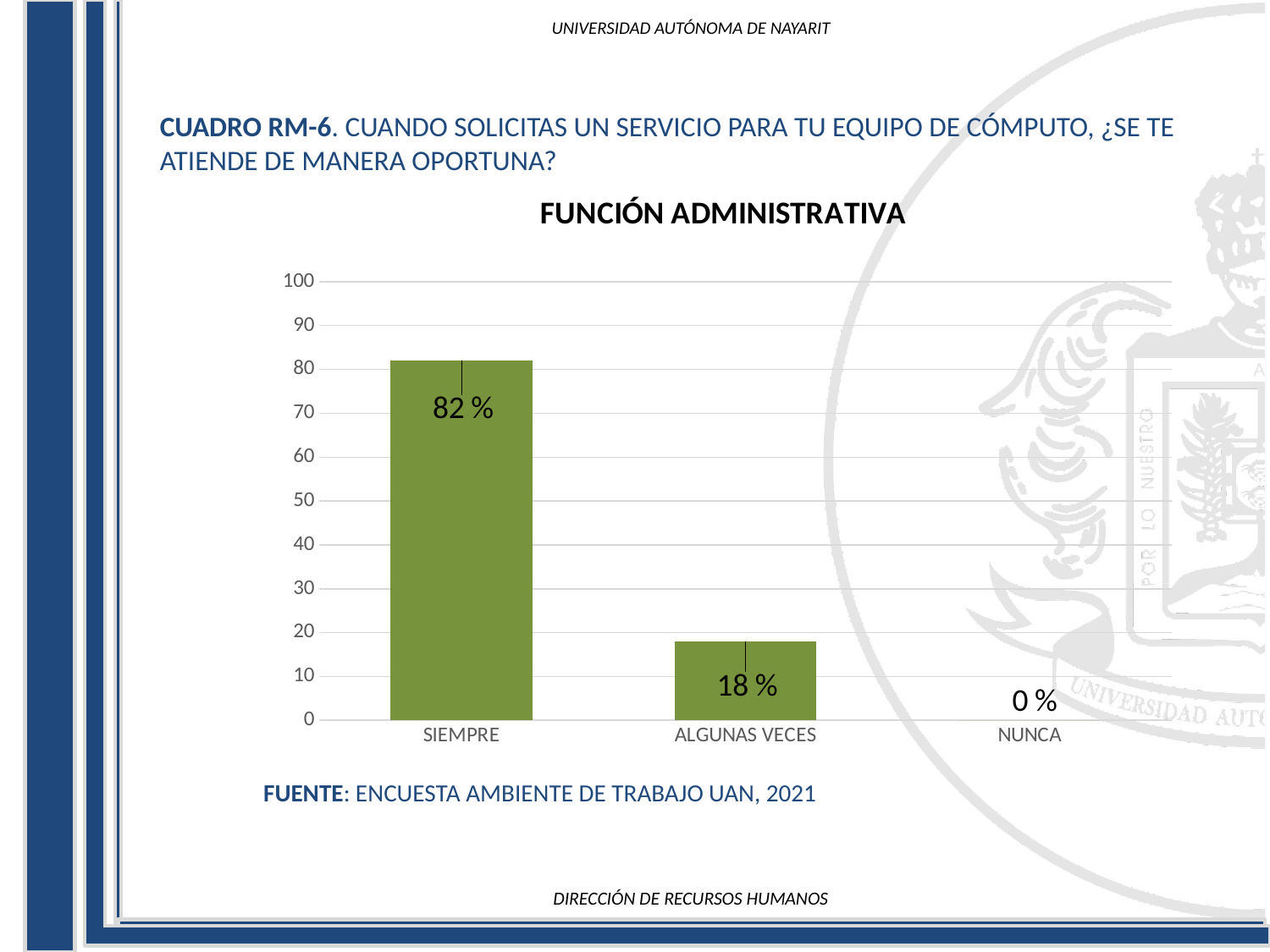
Is the value for ALGUNAS VECES greater or less than 30? less What is the value for ALGUNAS VECES? 18 % Which category has the lowest value? NUNCA How many categories are shown on the x axis? 3 Which category has the highest value? SIEMPRE What kind of chart is shown on the slide? bar chart Is the value for SIEMPRE greater or less than 50? greater What is the title of the chart? FUNCIÓN ADMINISTRATIVA Which is larger, the value for ALGUNAS VECES or the value for NUNCA? ALGUNAS VECES What is the value for SIEMPRE? 82 % What is the difference between the values for SIEMPRE and ALGUNAS VECES? 64 % What is the value for NUNCA? 0 %